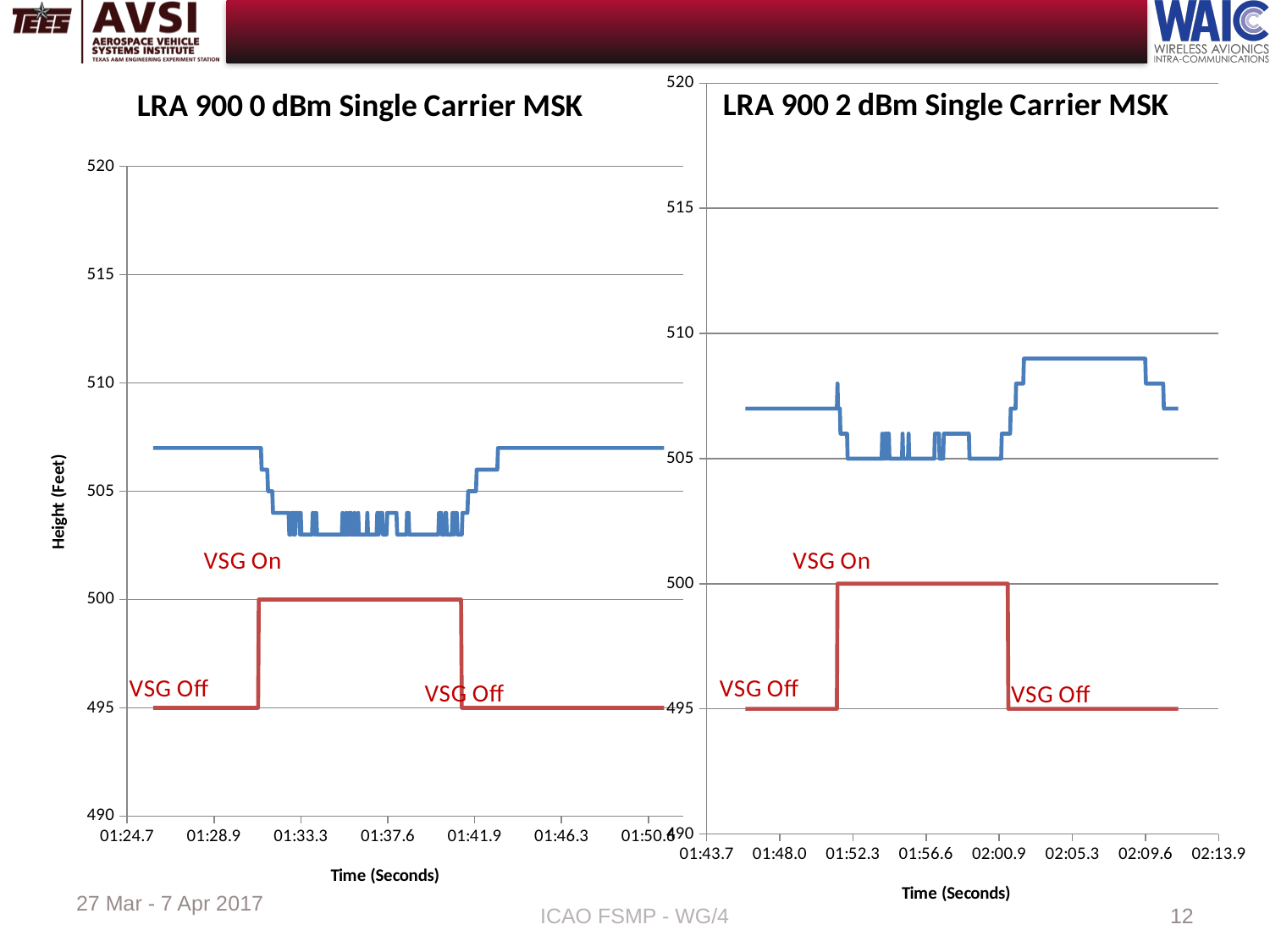
In the left chart, is the blue height line during the VSG On period greater or less than 505? less How many time labels are shown on the x axis of the right chart? 8 In the right chart, what value does the red line sit at while VSG is Off? 495 What is the title of the right chart? LRA 900 2 dBm Single Carrier MSK In the left chart, is the blue line higher before VSG turns on or during the VSG On period? before VSG turns on In the right chart, is the highest level reached by the blue line after VSG turns off greater or less than 510? less In the right chart, is the blue line's level after VSG turns off (around 02:05.3) greater or less than 505? greater What is the label on the vertical axis of the left chart? Height (Feet) In the left chart, does the blue height line rise or fall when VSG switches from Off to On? fall In the left chart, what value does the red line sit at while VSG is On? 500 What kind of chart is the left chart titled 'LRA 900 0 dBm Single Carrier MSK'? line chart